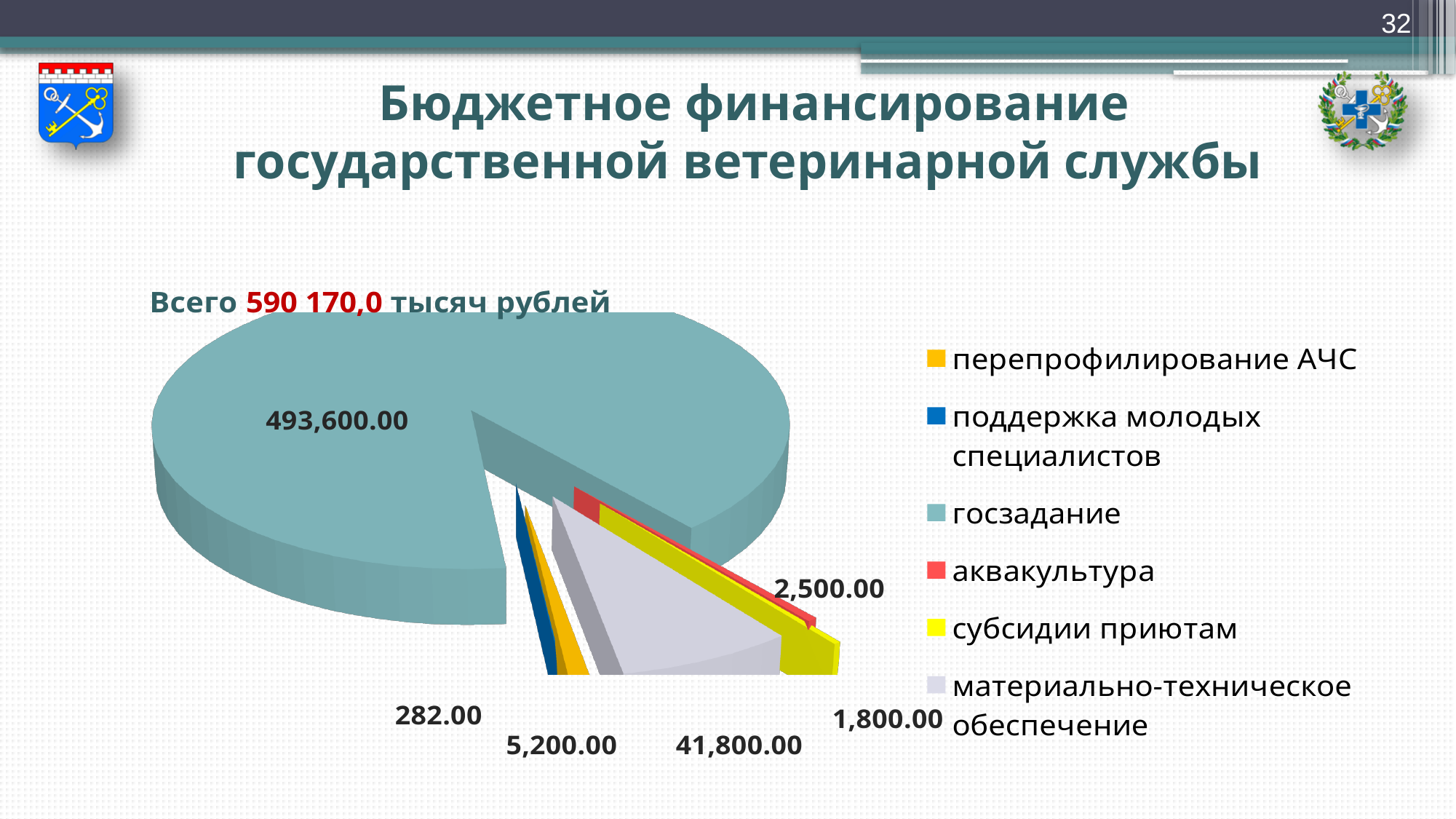
What kind of chart is shown on the slide? pie chart What is the difference between аквакультура and субсидии приютам? 700.00 Which is larger, аквакультура or субсидии приютам? аквакультура Which category has the smallest value? поддержка молодых специалистов What is the difference between материально-техническое обеспечение and перепрофилирование АЧС? 36,600.00 What value is shown for поддержка молодых специалистов? 282.00 What value is shown for аквакультура? 2,500.00 What value is shown for перепрофилирование АЧС? 5,200.00 What value is shown for материально-техническое обеспечение? 41,800.00 Which category has the largest slice of the pie? госзадание How many categories does the pie chart have? 6 What value is shown for госзадание on the pie chart? 493,600.00